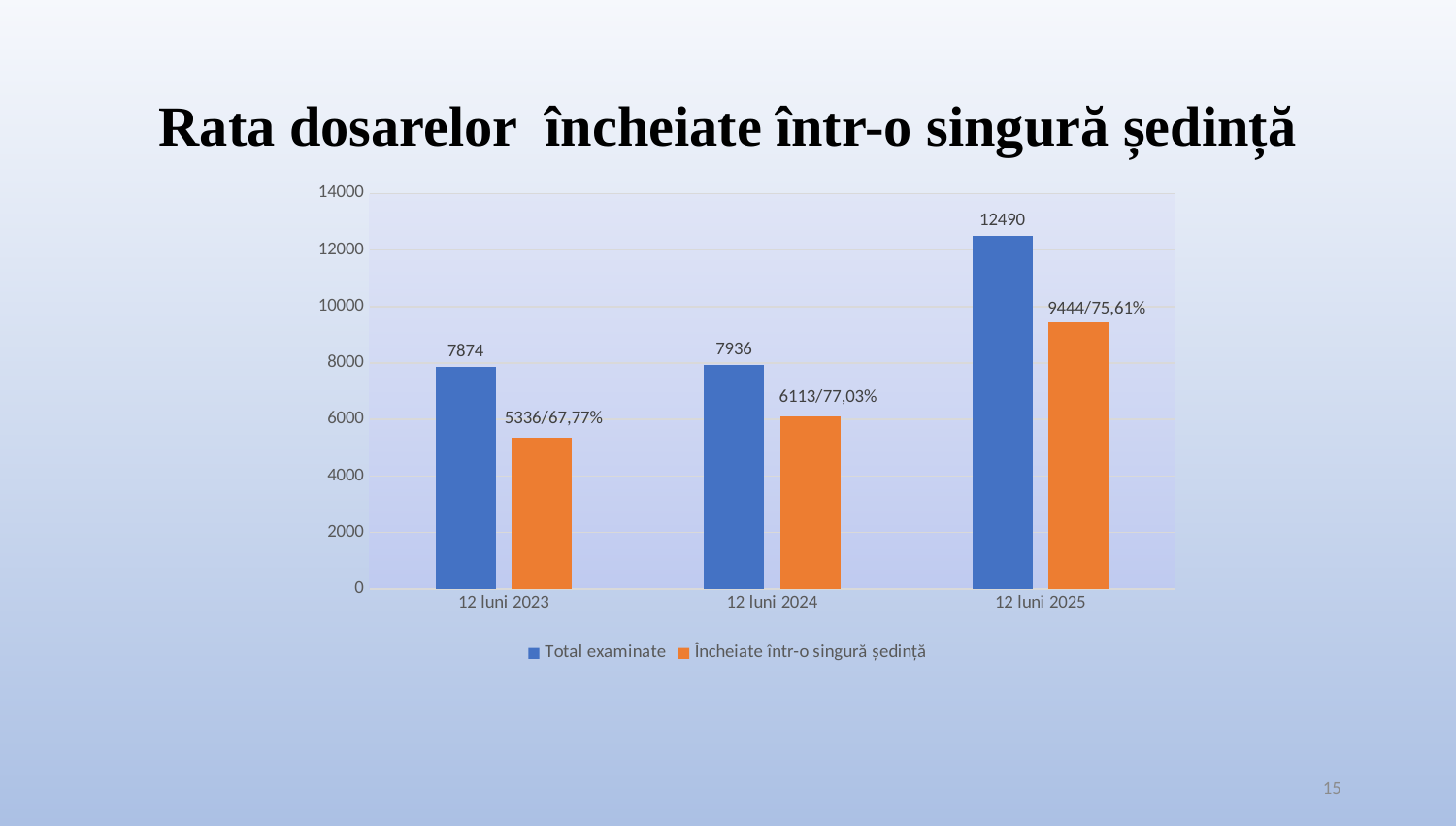
Which period has the lowest Încheiate într-o singură ședință value? 12 luni 2023 What is the data label on the Încheiate într-o singură ședință bar for 12 luni 2023? 5336/67,77% How many periods are shown on the x axis? 3 Which is larger: Total examinate for 12 luni 2023 or Încheiate într-o singură ședință for 12 luni 2025? Încheiate într-o singură ședință for 12 luni 2025 What type of chart is shown on the slide? bar chart Which period has the highest Total examinate value? 12 luni 2025 How many series does the legend list? 2 Is the Total examinate value for 12 luni 2025 greater or less than 12000? greater What is the difference between Total examinate for 12 luni 2025 and 12 luni 2024? 4554 What is the value of Total examinate for 12 luni 2024? 7936 What is the value of Total examinate for 12 luni 2025? 12490 What is the data label on the Încheiate într-o singură ședință bar for 12 luni 2025? 9444/75,61%